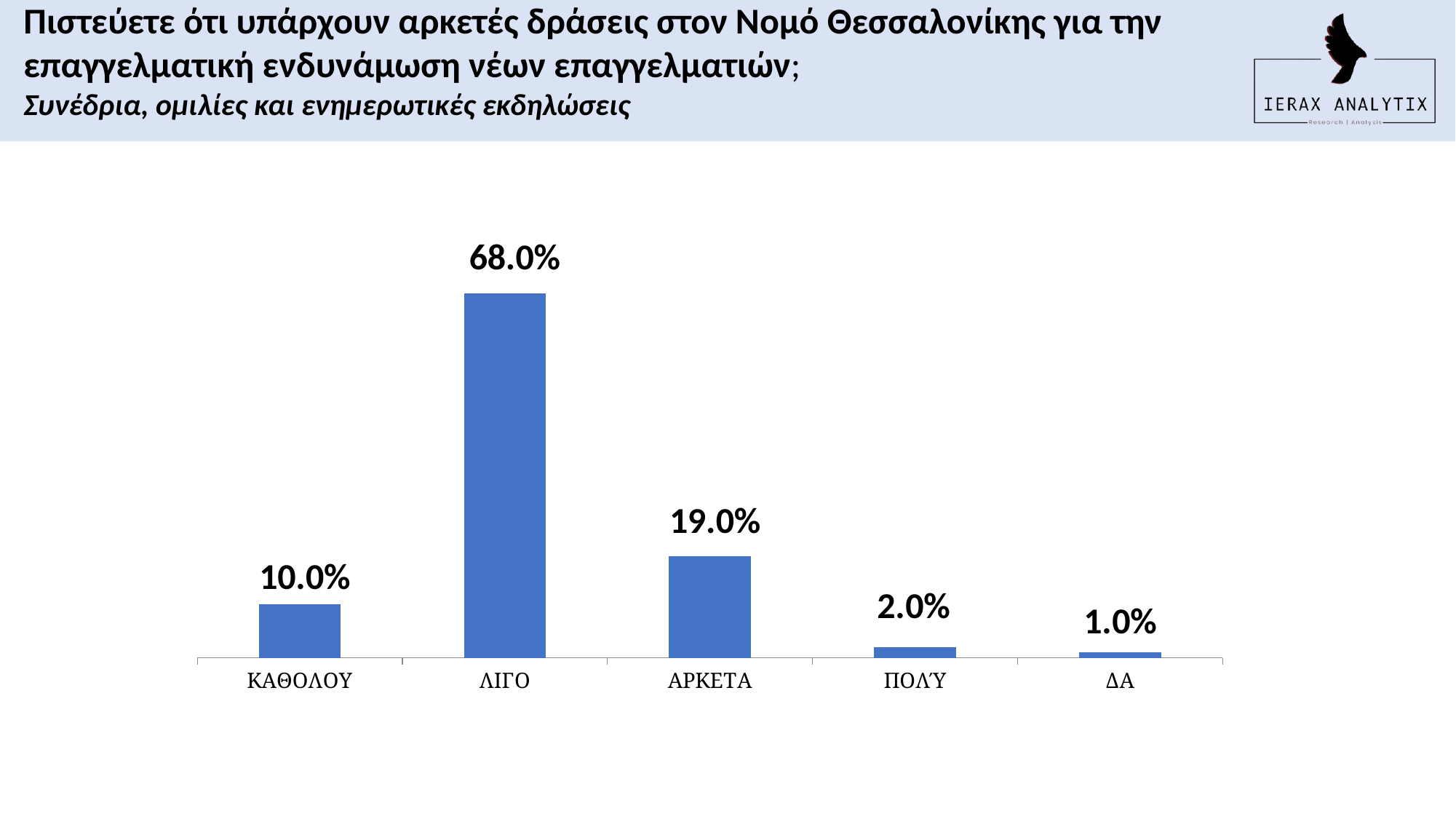
Which is larger, the value for ΚΑΘΟΛΟΥ or the value for ΑΡΚΕΤΑ? ΑΡΚΕΤΑ What is the value for ΠΟΛΎ? 2.0% What is the value for ΑΡΚΕΤΑ? 19.0% What is the value for ΛΙΓΟ? 68.0% Which category has the lowest value? ΔΑ What is the difference between the values for ΛΙΓΟ and ΑΡΚΕΤΑ? 49.0% What kind of chart is shown on the slide? Bar chart What colour are the bars in the chart? Blue What is the value for ΔΑ? 1.0% How many categories are shown on the x axis? 5 What is the value for ΚΑΘΟΛΟΥ? 10.0% Which category has the highest value? ΛΙΓΟ